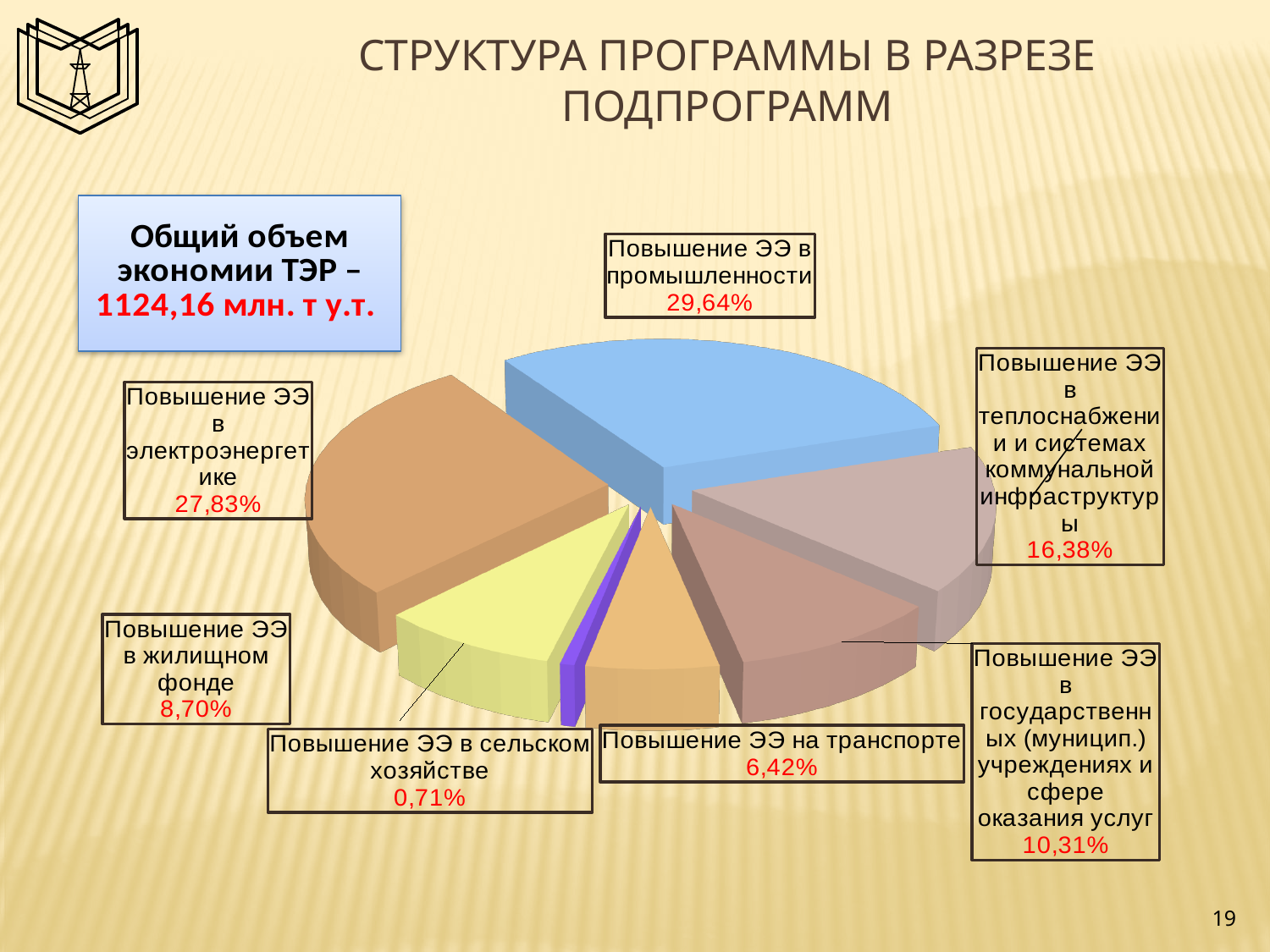
What is the difference in share between "Повышение ЭЭ в промышленности" and "Повышение ЭЭ в электроэнергетике"? 1,81% Which category has the smallest share in the pie chart? Повышение ЭЭ в сельском хозяйстве Which has a larger share: "Повышение ЭЭ в жилищном фонде" or "Повышение ЭЭ на транспорте"? Повышение ЭЭ в жилищном фонде What share does "Повышение ЭЭ в промышленности" have in the pie chart? 29,64% How many slices does the pie chart have? 7 What total volume of fuel and energy savings (Общий объем экономии ТЭР) is stated on the slide? 1124,16 млн. т у.т. What share does "Повышение ЭЭ на транспорте" have in the pie chart? 6,42% What share does "Повышение ЭЭ в жилищном фонде" have in the pie chart? 8,70% What kind of chart is shown on the slide? Pie chart What is the difference in share between "Повышение ЭЭ в теплоснабжении и системах коммунальной инфраструктуры" and "Повышение ЭЭ в государственных (муницип.) учреждениях и сфере оказания услуг"? 6,07% Which category has the largest share in the pie chart? Повышение ЭЭ в промышленности What share does "Повышение ЭЭ в электроэнергетике" have in the pie chart? 27,83%